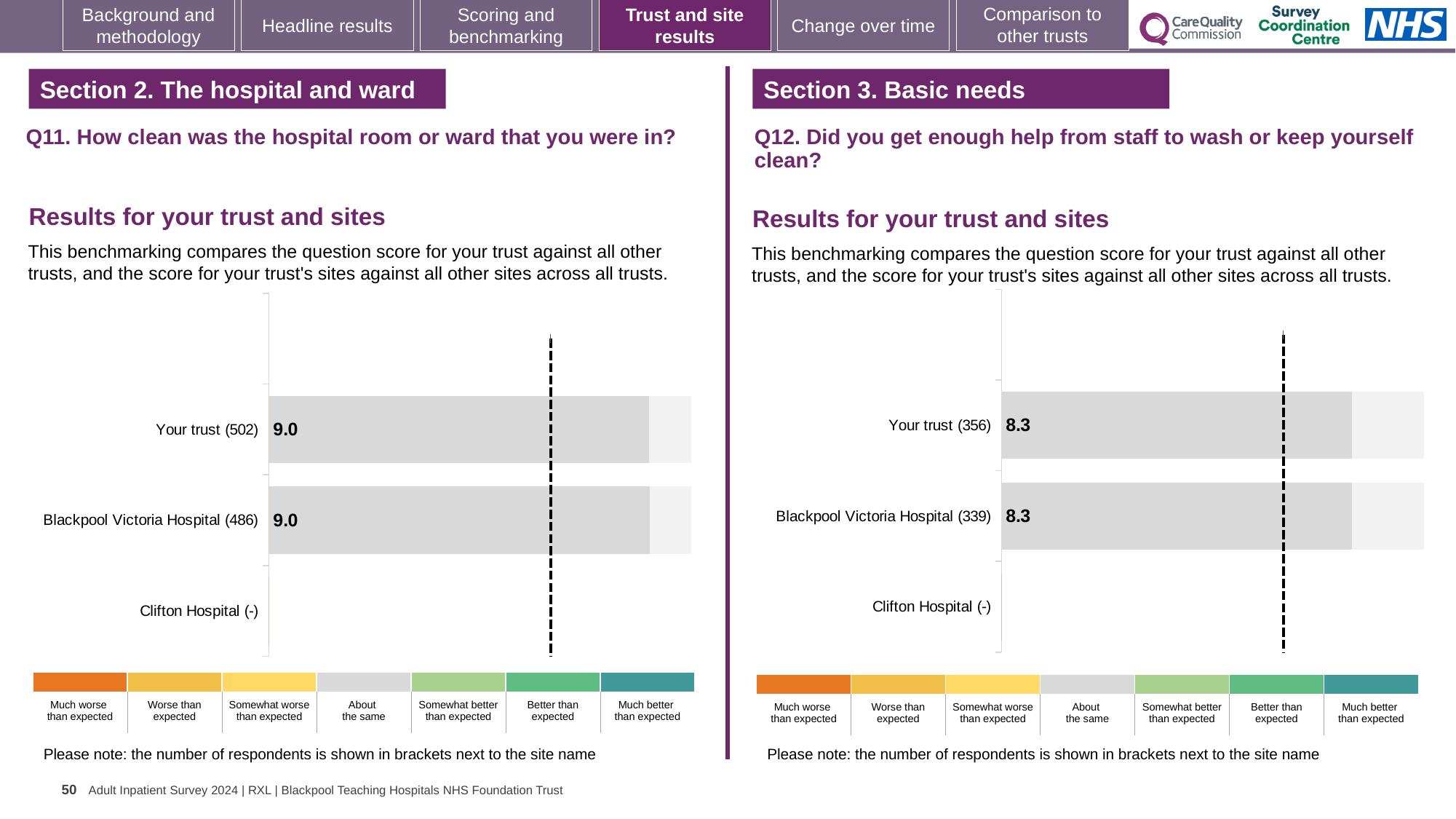
In the Q12 chart on the right, what is the score for Your trust (356)? 8.3 In the Q11 chart on the left, what is the score for Blackpool Victoria Hospital (486)? 9.0 How many site/trust categories are listed on the y axis of the Q12 chart on the right? 3 How many respondents are shown in brackets for Your trust in the Q12 chart on the right? 356 In the Q11 chart on the left, what is the difference between the score for Your trust and the score for Blackpool Victoria Hospital? 0.0 In the Q12 chart on the right, what is the difference between the score for Your trust and the score for Blackpool Victoria Hospital? 0.0 What kind of chart is used for the Q11 results on the left? Bar chart In the Q11 chart on the left, which category has no bar plotted? Clifton Hospital (-) What kind of chart is used for the Q12 results on the right? Bar chart How many site/trust categories are listed on the y axis of the Q11 chart on the left? 3 In the Q12 chart on the right, what is the score for Blackpool Victoria Hospital (339)? 8.3 In the Q11 chart on the left, what is the score for Your trust (502)? 9.0